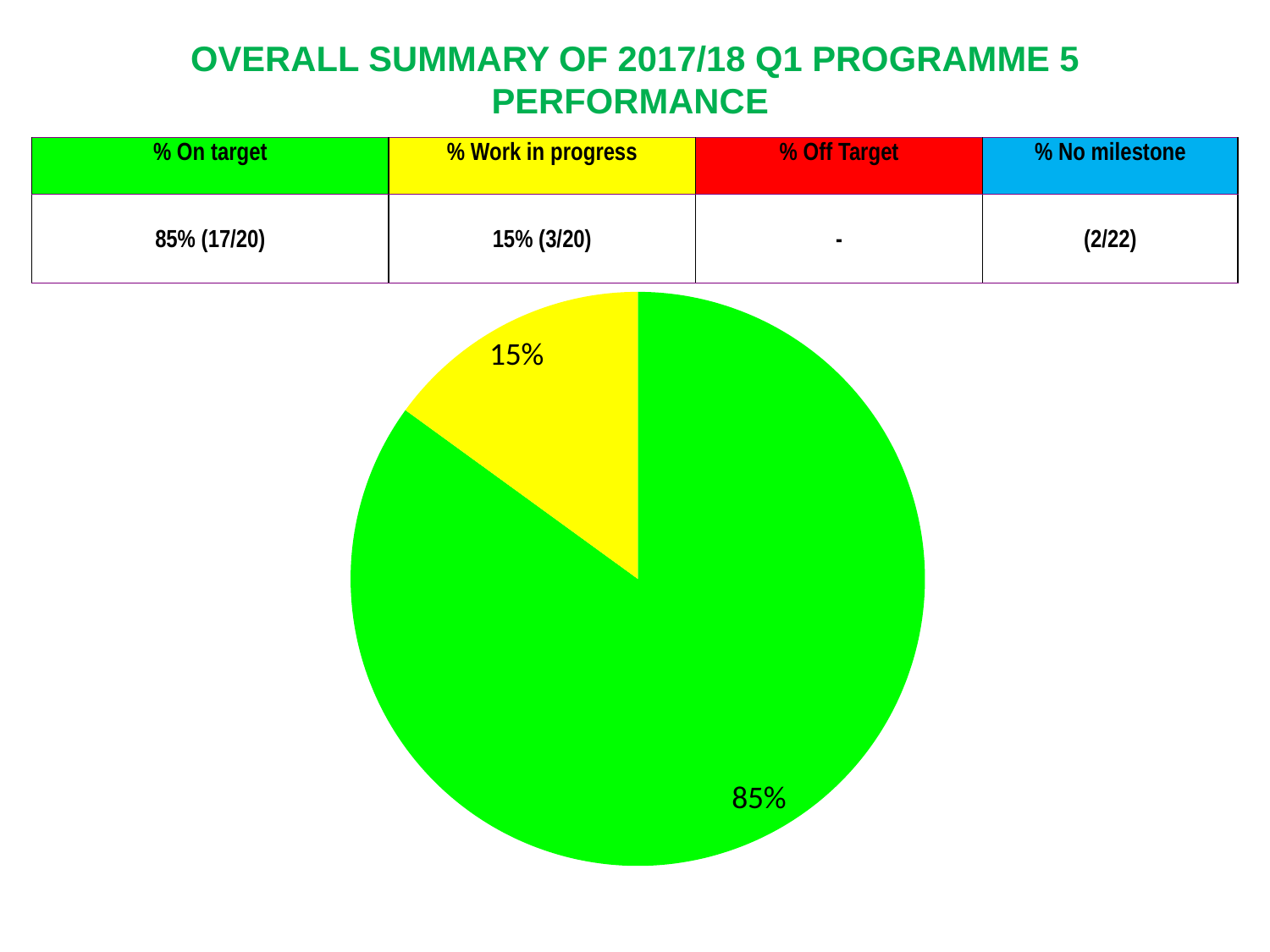
Which is larger, the green slice or the yellow slice? the green slice How many slices does the pie chart have? 2 Which slice of the pie chart is the largest? the green slice (85%) What share of the pie does the yellow slice represent? 15% What is the difference in percentage points between the green slice and the yellow slice? 70 percentage points Is the share of the yellow slice greater or less than 50%? less What kind of chart is shown on the slide? pie chart What do the two slices of the pie chart add up to? 100% According to the table above the chart, which status does the yellow slice of the pie correspond to? % Work in progress Which slice of the pie chart is the smallest? the yellow slice (15%) According to the table above the chart, which status does the green slice of the pie correspond to? % On target What share of the pie does the green slice represent? 85%